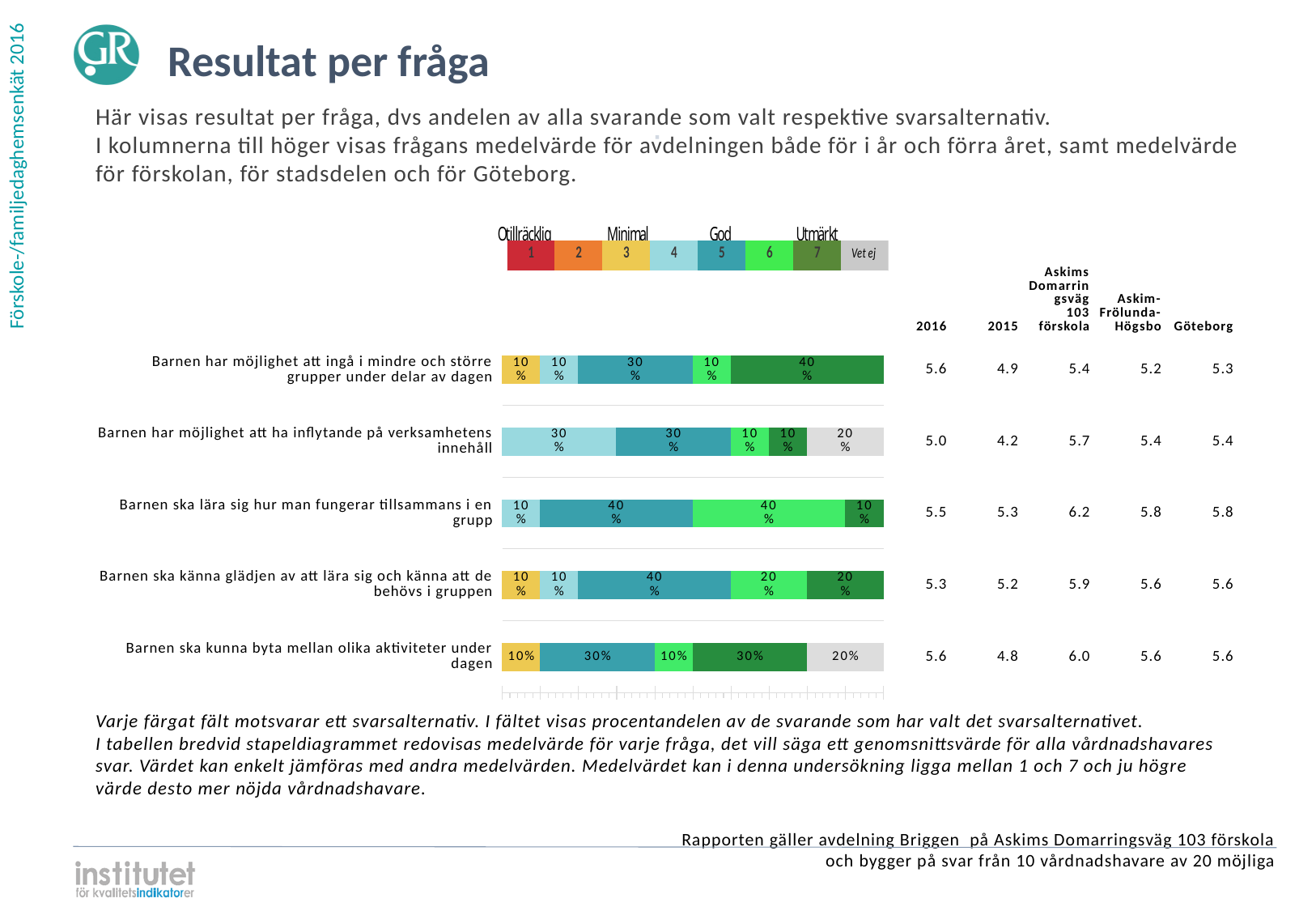
What percentage chose 'Vet ej' for 'Barnen har möjlighet att ha inflytande på verksamhetens innehåll'? 20% What percentage of respondents chose answer 7 (dark green) for 'Barnen har möjlighet att ingå i mindre och större grupper under delar av dagen'? 40% What percentage chose answer 3 (yellow) for 'Barnen ska kunna byta mellan olika aktiviteter under dagen'? 10% What kind of chart is shown on the slide? Stacked bar chart How many questions (bars) are shown in the chart? 5 How many answer alternatives does the legend above the chart list? 8 For 'Barnen ska lära sig hur man fungerar tillsammans i en grupp', which is larger: the share for answer 5 or the share for answer 7? Answer 5 What is the 2016 mean value shown for 'Barnen har möjlighet att ha inflytande på verksamhetens innehåll'? 5.0 For 'Barnen ska kunna byta mellan olika aktiviteter under dagen', what is the difference between the share for answer 5 and the share for answer 6? 20% What percentage chose answer 5 (teal) for 'Barnen ska känna glädjen av att lära sig och känna att de behövs i gruppen'? 40% What is the combined share of answers 6 and 7 for 'Barnen ska känna glädjen av att lära sig och känna att de behövs i gruppen'? 40% Which answer alternative has the largest share for 'Barnen har möjlighet att ingå i mindre och större grupper under delar av dagen'? 7